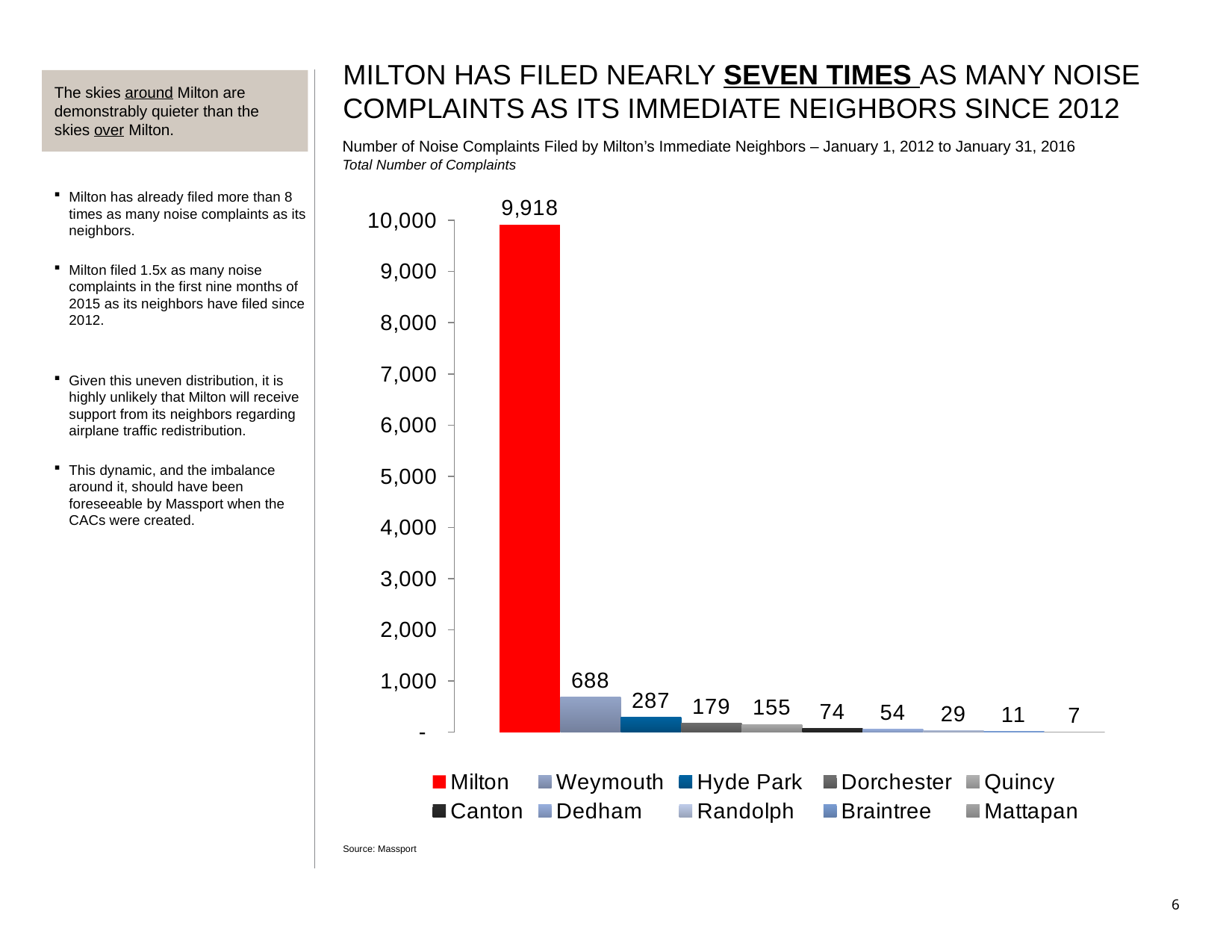
What type of chart is shown on the slide? Bar chart What is the difference between the complaints filed by Milton and Weymouth? 9,230 How many noise complaints did Milton file according to the chart? 9,918 What is the difference between the values for Dorchester and Quincy? 24 What value is shown for Mattapan? 7 Which community has the highest number of noise complaints? Milton Which community has the lowest number of noise complaints? Mattapan What value is shown for Hyde Park? 287 How many communities are shown in the chart? 10 What is the source cited for the chart? Massport Which has more noise complaints, Canton or Dedham? Canton What is the number of noise complaints shown for Weymouth? 688